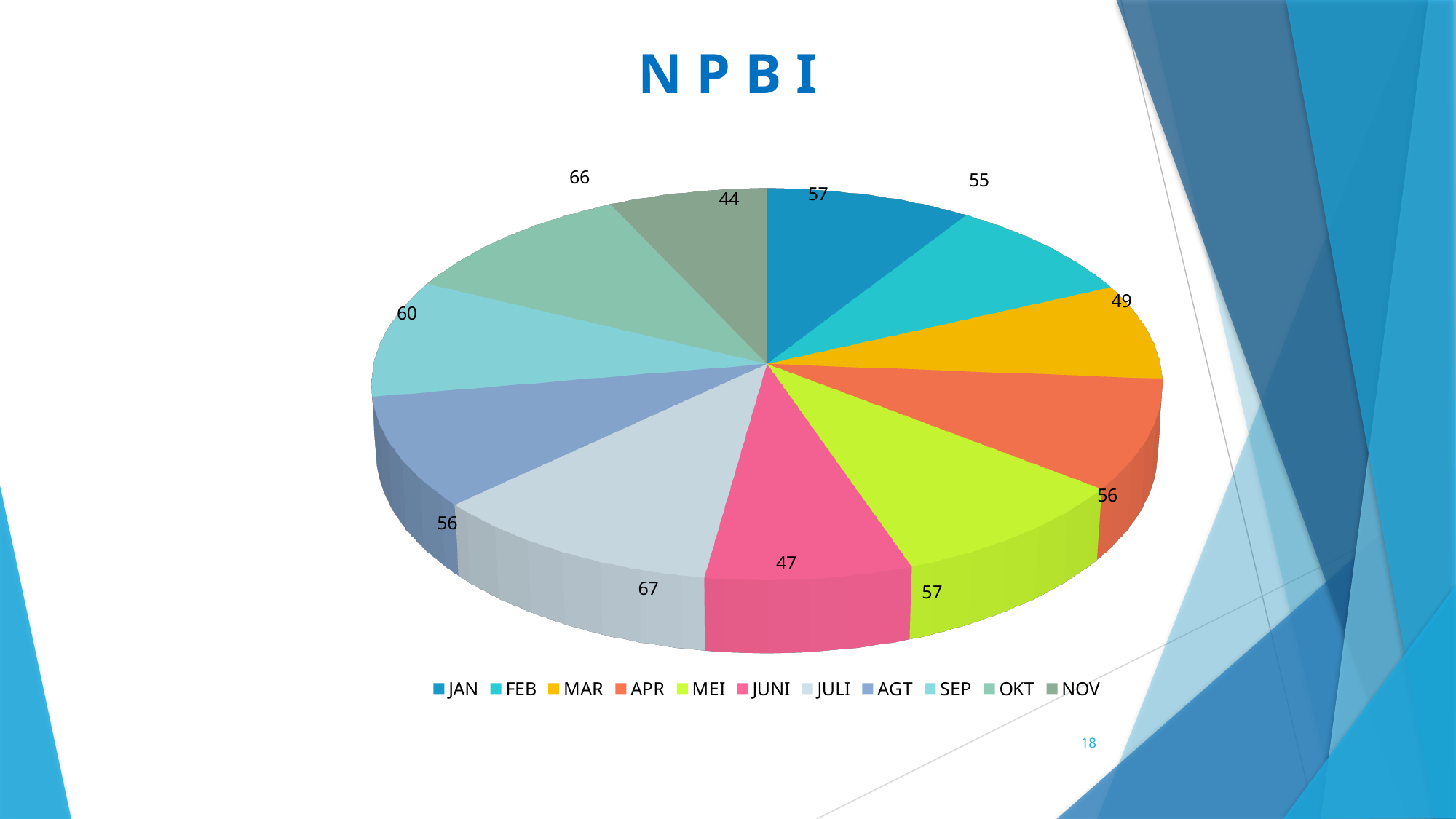
What is the value for JUNI in the pie chart? 47 How many slices does the pie chart have? 11 Which month has the smallest slice in the pie chart? NOV Which month has the largest slice in the pie chart? JULI What is the value for SEP in the pie chart? 60 What kind of chart is shown on the slide? Pie chart What is the value for NOV in the pie chart? 44 What is the value for JULI in the pie chart? 67 What is the difference between the values for OKT and SEP? 6 What is the difference between the values for JULI and NOV? 23 Which is larger, the value for FEB or the value for MAR? FEB What is the title of the chart? N P B I